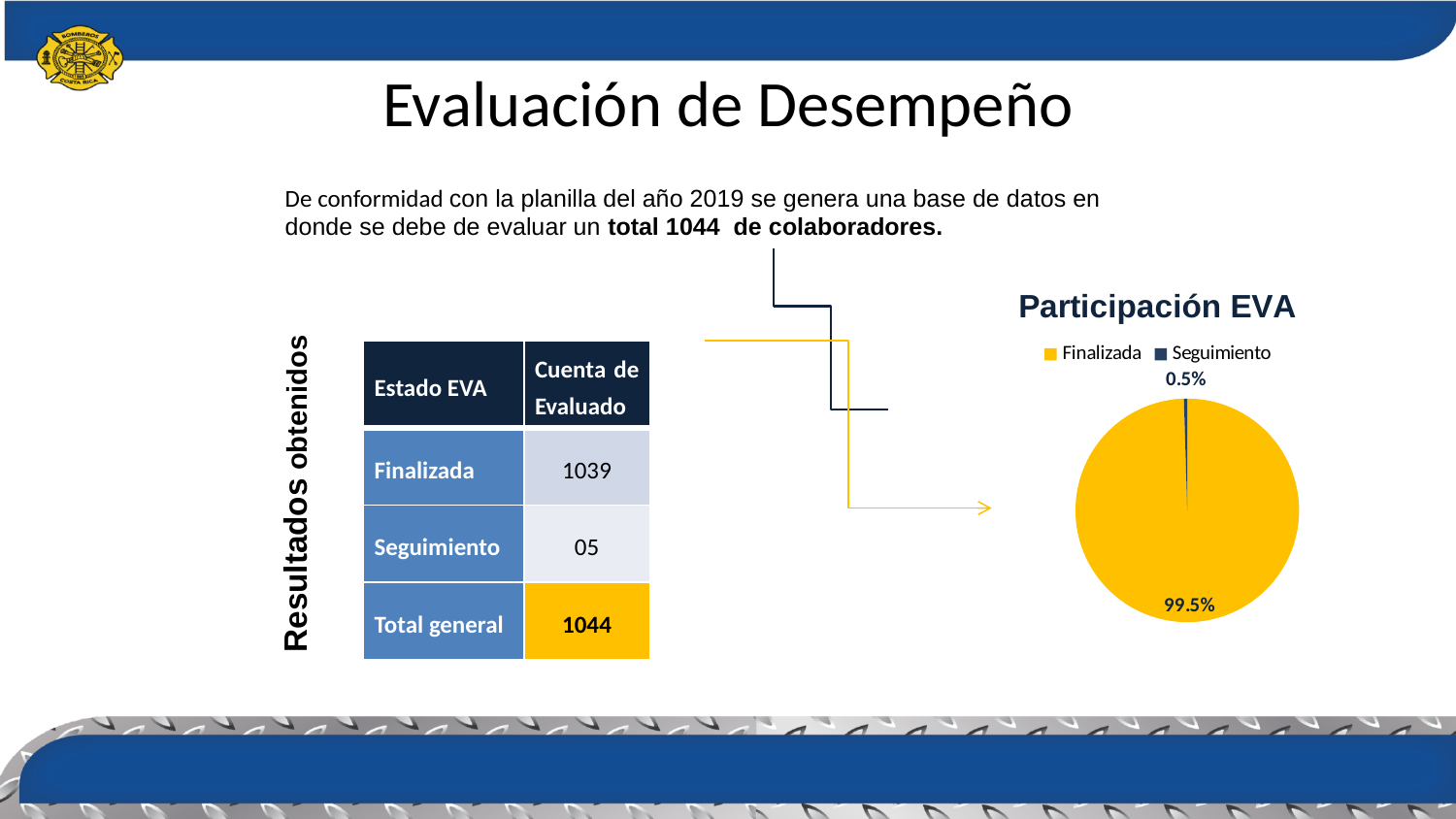
Which is larger in the pie chart, Finalizada or Seguimiento? Finalizada What is the difference in percentage points between the Finalizada and Seguimiento slices? 99.0 percentage points What share of the pie does Seguimiento represent? 0.5% How many slices does the pie chart have? 2 What is the title of the chart on the slide? Participación EVA What colour is the Finalizada slice in the pie chart? yellow What share of the pie does Finalizada represent? 99.5% How many entries does the legend of the pie chart list? 2 Which slice of the pie chart is the smallest? Seguimiento Which slice of the pie chart is the largest? Finalizada What kind of chart is shown under the title "Participación EVA"? pie chart